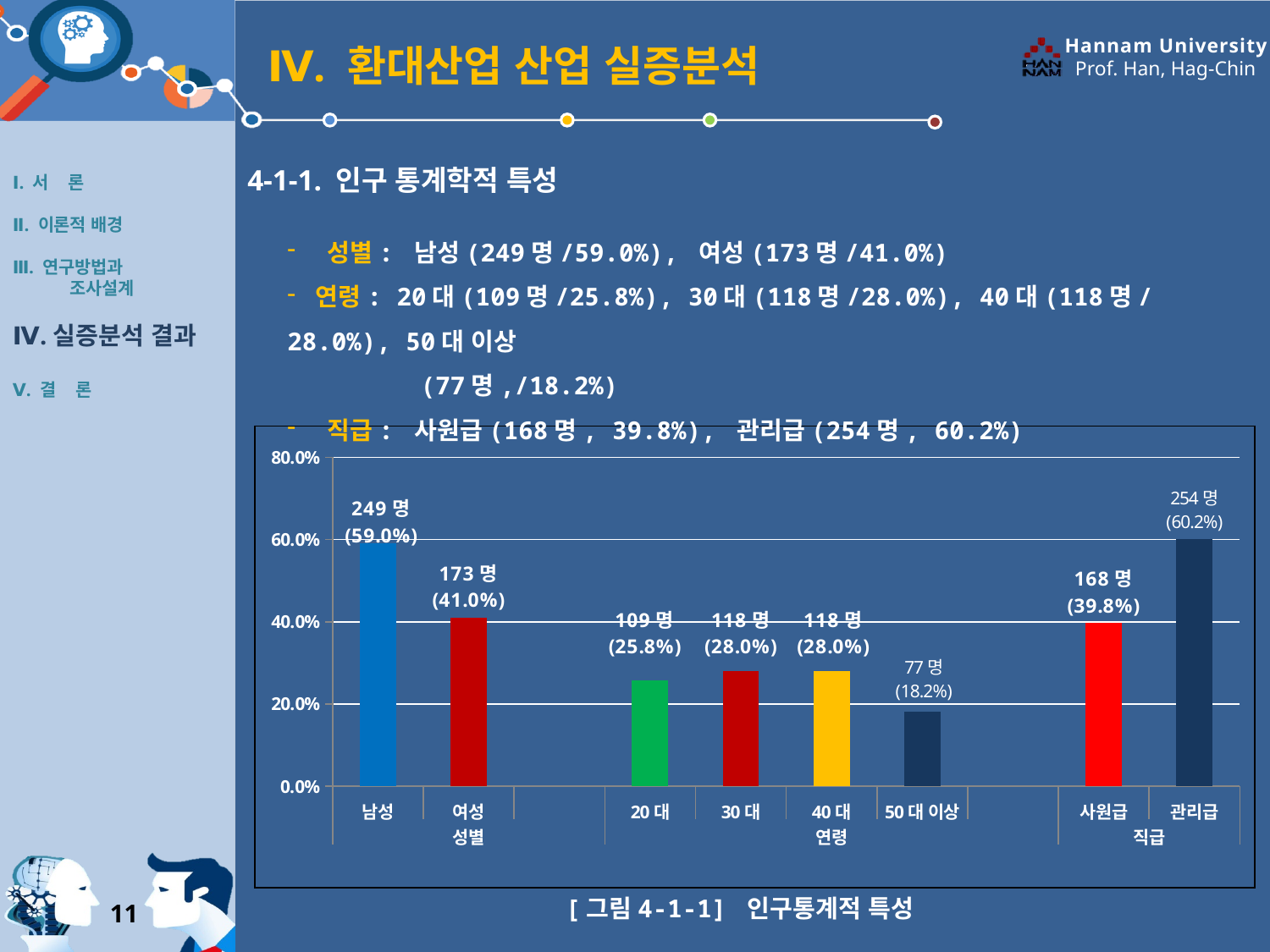
Which category has the highest percentage in the chart? 관리급 How many people (명) are shown for 관리급 in the chart? 254 명 Which category has the lowest percentage in the chart? 50 대 이상 What kind of chart is shown on the slide? bar chart What is the difference in percentage points between 남성 and 여성? 18.0% How many bars are plotted in the chart? 8 How many people (명) are shown for 여성 in the chart? 173 명 What is the difference in number of people between 관리급 and 사원급? 86 명 Which is larger, the value for 20 대 or the value for 30 대? 30 대 What percentage is shown for 남성 in the chart? 59.0% Is the value for 사원급 greater or less than 40.0%? less What percentage is shown for 50 대 이상 in the chart? 18.2%